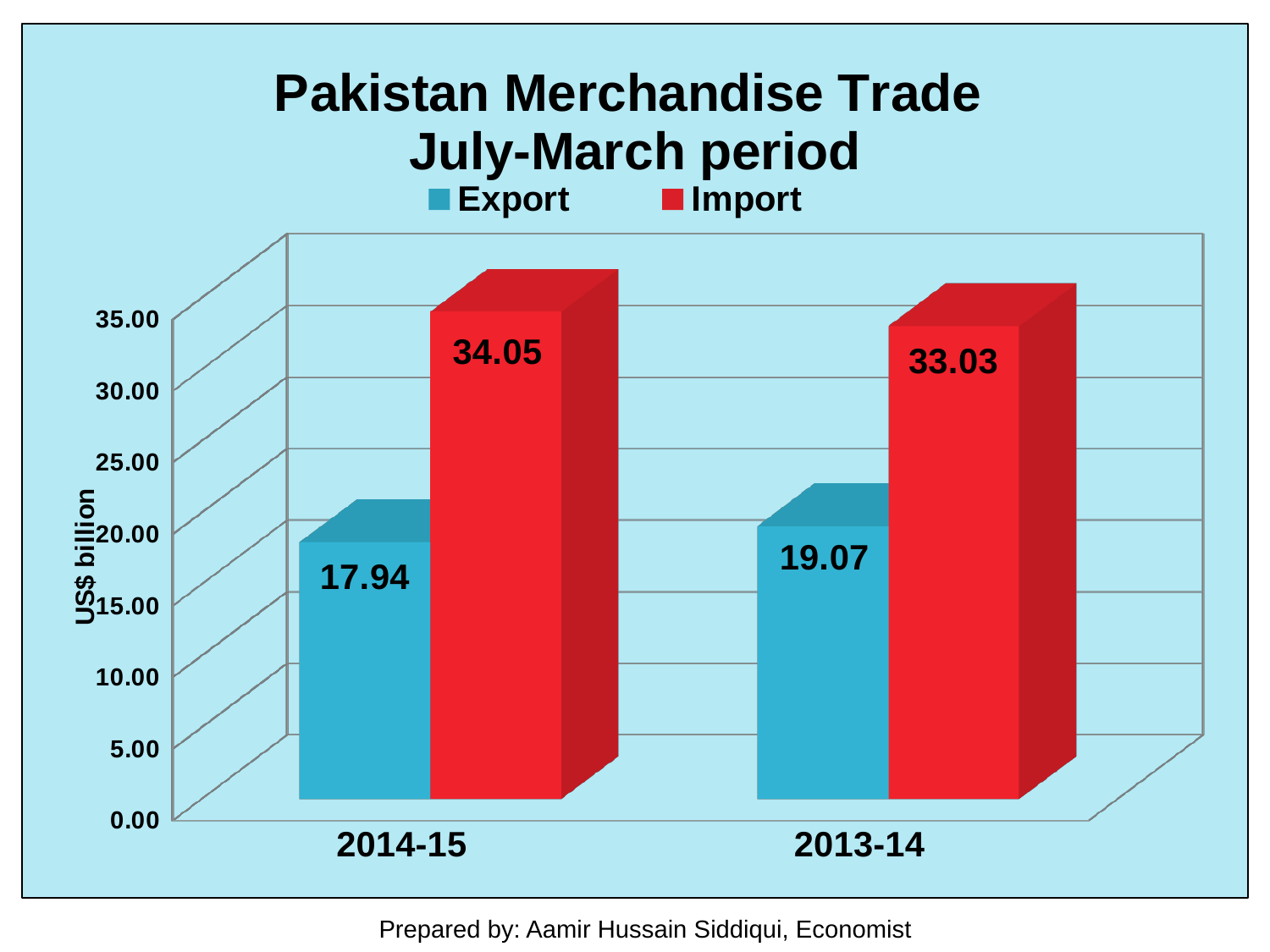
Which period has the higher Import value? 2014-15 What is the Export value for 2014-15? 17.94 What is the Import value for 2014-15? 34.05 How many series does the legend list? 2 Which period has the lower Export value? 2014-15 What kind of chart is shown on the slide? Bar chart What is the Import value for 2013-14? 33.03 Is the Export value for 2013-14 greater or less than 20.00? less What is the difference between Import and Export in 2014-15? 16.11 What is the Export value for 2013-14? 19.07 What is the label on the vertical axis? US$ billion What is the difference between the Export values for 2013-14 and 2014-15? 1.13